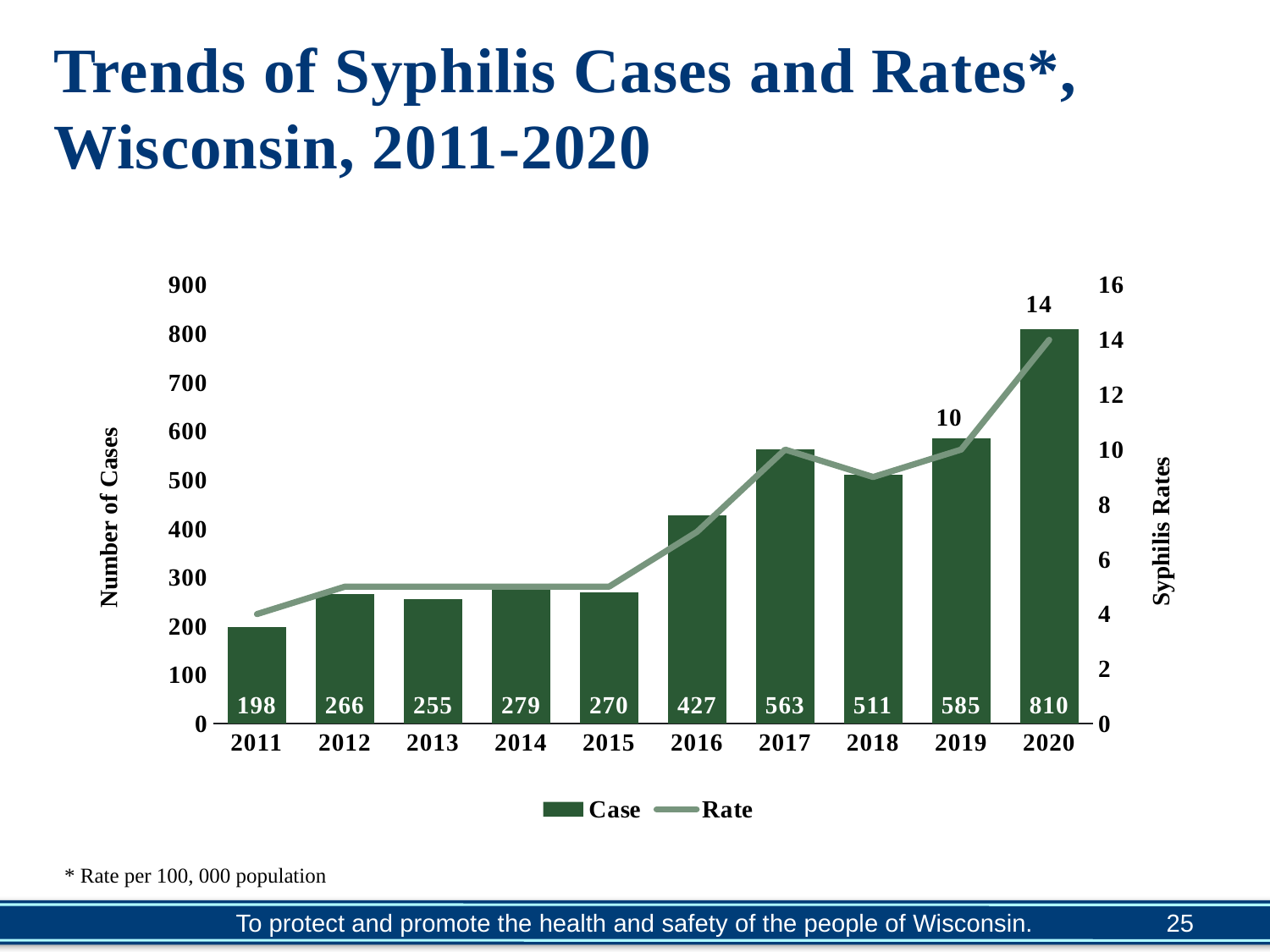
What is the overall trend in the number of syphilis cases from 2011 to 2020? Rising What was the number of syphilis cases in 2011? 198 Which year had the highest number of syphilis cases? 2020 What was the syphilis rate in 2019? 10 How many syphilis cases were reported in Wisconsin in 2016? 427 How many years are shown on the x axis of the chart? 10 Which year had more syphilis cases, 2017 or 2018? 2017 How many more syphilis cases were there in 2020 than in 2019? 225 What was the syphilis rate in 2020? 14 Is the syphilis rate for 2015 greater or less than 8? less Which year had the lowest number of syphilis cases? 2011 How many series does the chart legend list? 2